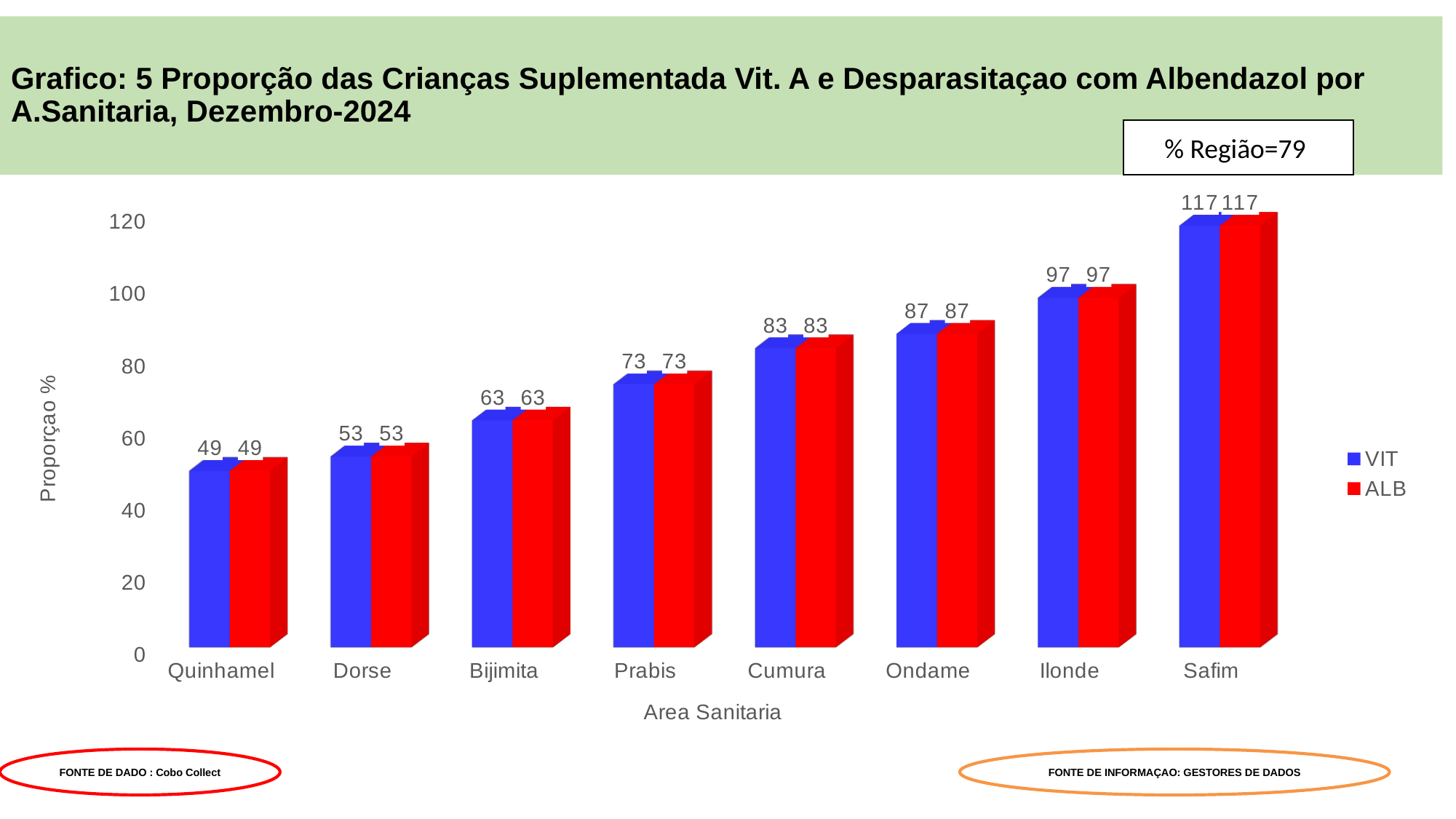
Which is larger, the ALB value for Ondame or the ALB value for Prabis? Ondame What kind of chart is shown on the slide? bar chart Do the VIT values rise or fall from Quinhamel to Safim along the x axis? rise Which area sanitaria has the lowest ALB value? Quinhamel What is the ALB value for Ilonde? 97 Is the VIT value for Dorse greater or less than 60? less How many series does the legend list? 2 What is the VIT value for Quinhamel? 49 What is the VIT value for Cumura? 83 What is the difference between the VIT values for Safim and Quinhamel? 68 Which area sanitaria has the highest VIT value? Safim How many areas sanitarias are shown on the x axis? 8